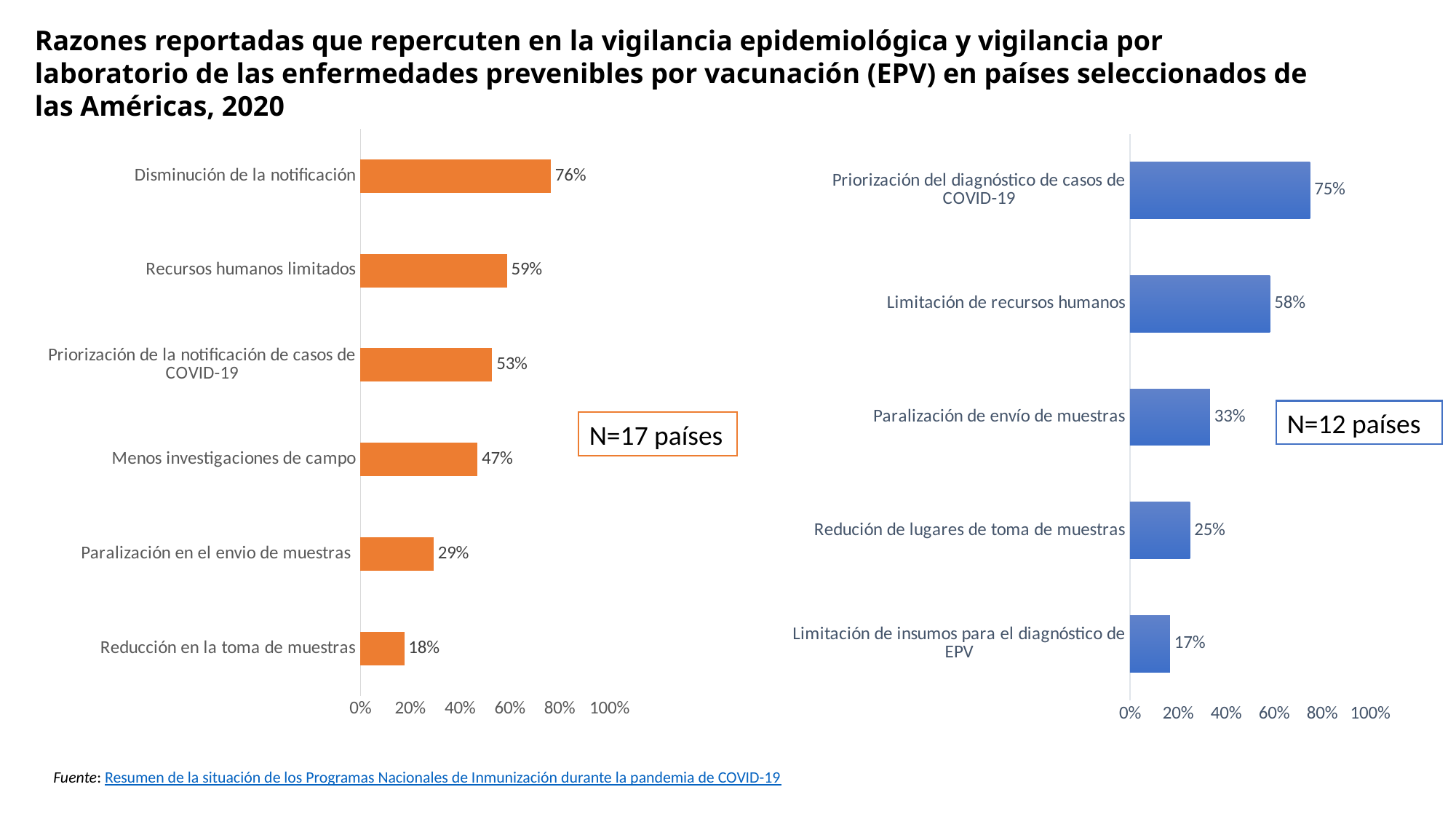
In the right chart (blue bars, N=12 países), what is the value for Paralización de envío de muestras? 33% How many categories are shown in the left chart (orange bars)? 6 In the left chart (orange bars), what is the difference between Recursos humanos limitados and Paralización en el envio de muestras? 30% How many countries (N) does the left chart (orange bars) cover? N=17 países How many categories are shown in the right chart (blue bars)? 5 What kind of chart is the right chart (blue bars)? Bar chart In the right chart (blue bars), is the value for Limitación de insumos para el diagnóstico de EPV greater or less than 20%? less In the right chart (blue bars), which category has the highest value? Priorización del diagnóstico de casos de COVID-19 In the right chart (blue bars), what is the difference between Limitación de recursos humanos and Redución de lugares de toma de muestras? 33% In the left chart (orange bars), which category has the lowest value? Reducción en la toma de muestras In the left chart (orange bars), which is larger: Priorización de la notificación de casos de COVID-19 or Menos investigaciones de campo? Priorización de la notificación de casos de COVID-19 In the left chart (orange bars, N=17 países), what is the value for Disminución de la notificación? 76%